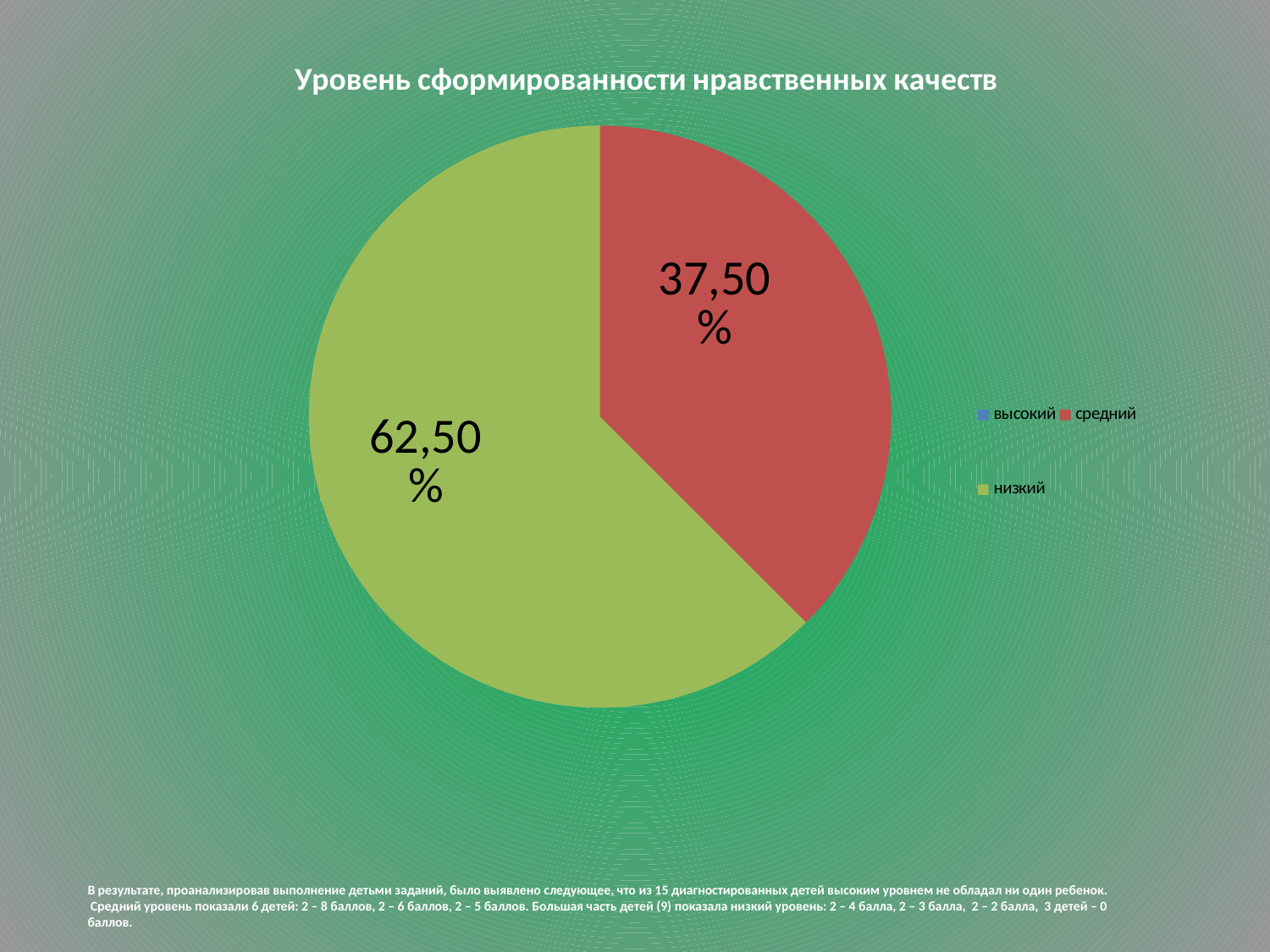
What share of the pie does the низкий slice take? 62,50% How many slices with data labels are visible in the pie? 2 What colour is used for the низкий category in the chart? green What kind of chart is shown on the slide? pie chart What is the title of the chart? Уровень сформированности нравственных качеств What is the difference between the низкий and средний percentages? 25,00% Is the средний slice greater or less than 50% of the pie? less Which category has the largest slice of the pie? низкий What percentage is shown for the средний slice? 37,50% What percentage is shown for the низкий slice? 62,50% How many entries does the legend list? 3 Which of the two labelled slices is smaller, средний or низкий? средний